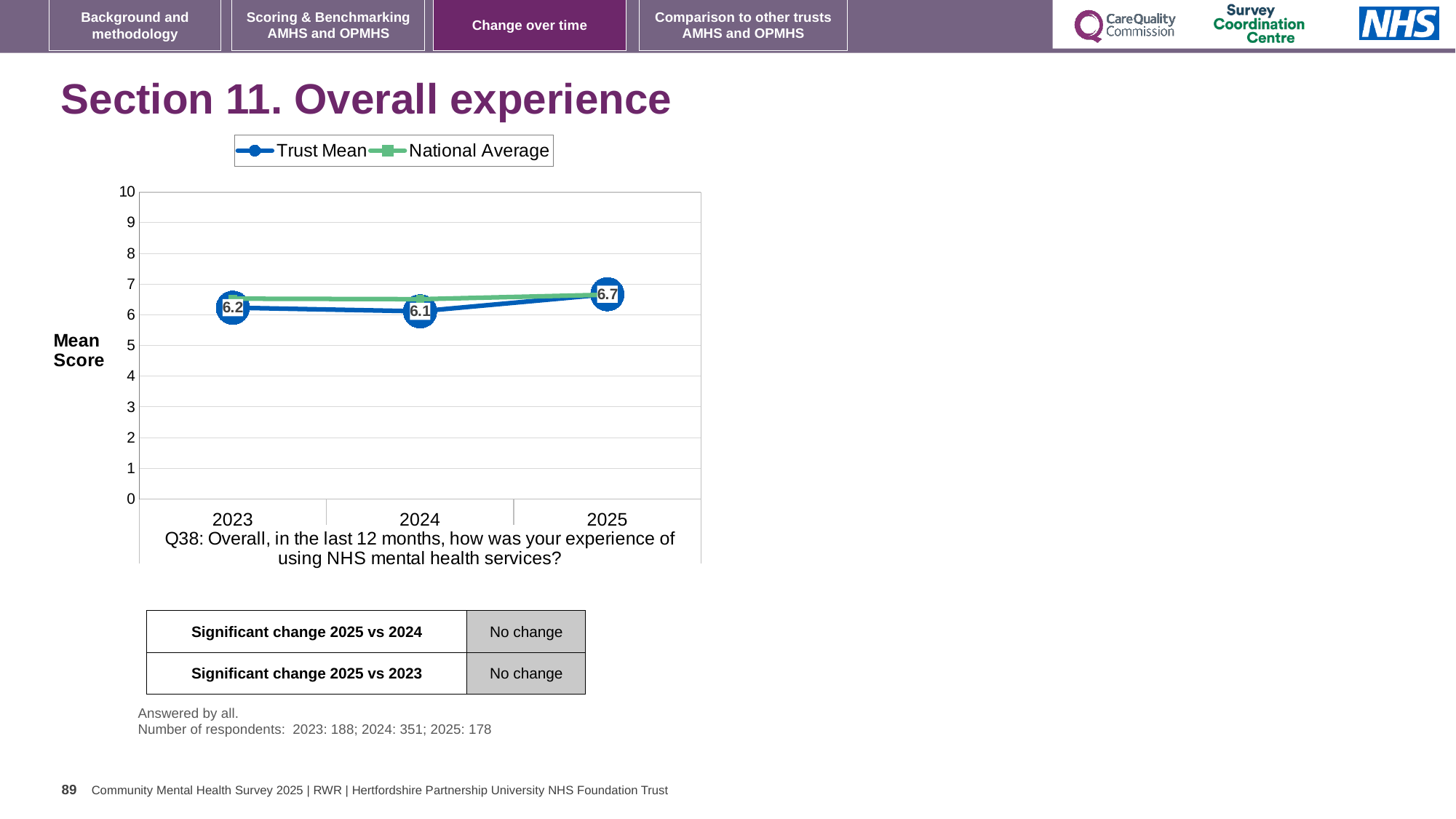
What is the Trust Mean value for 2024? 6.1 In which year is the Trust Mean highest? 2025 How many series does the legend list? 2 How many years are plotted on the x axis? 3 What is the Trust Mean value for 2023? 6.2 Which is larger, the Trust Mean in 2025 or the Trust Mean in 2023? 2025 In 2024, which is higher, the Trust Mean or the National Average? National Average What is the difference between the Trust Mean in 2025 and in 2024? 0.6 Is the National Average value for 2023 greater or less than 6? greater What is the Trust Mean value for 2025? 6.7 In which year is the Trust Mean lowest? 2024 What kind of chart is shown on the slide? Line chart